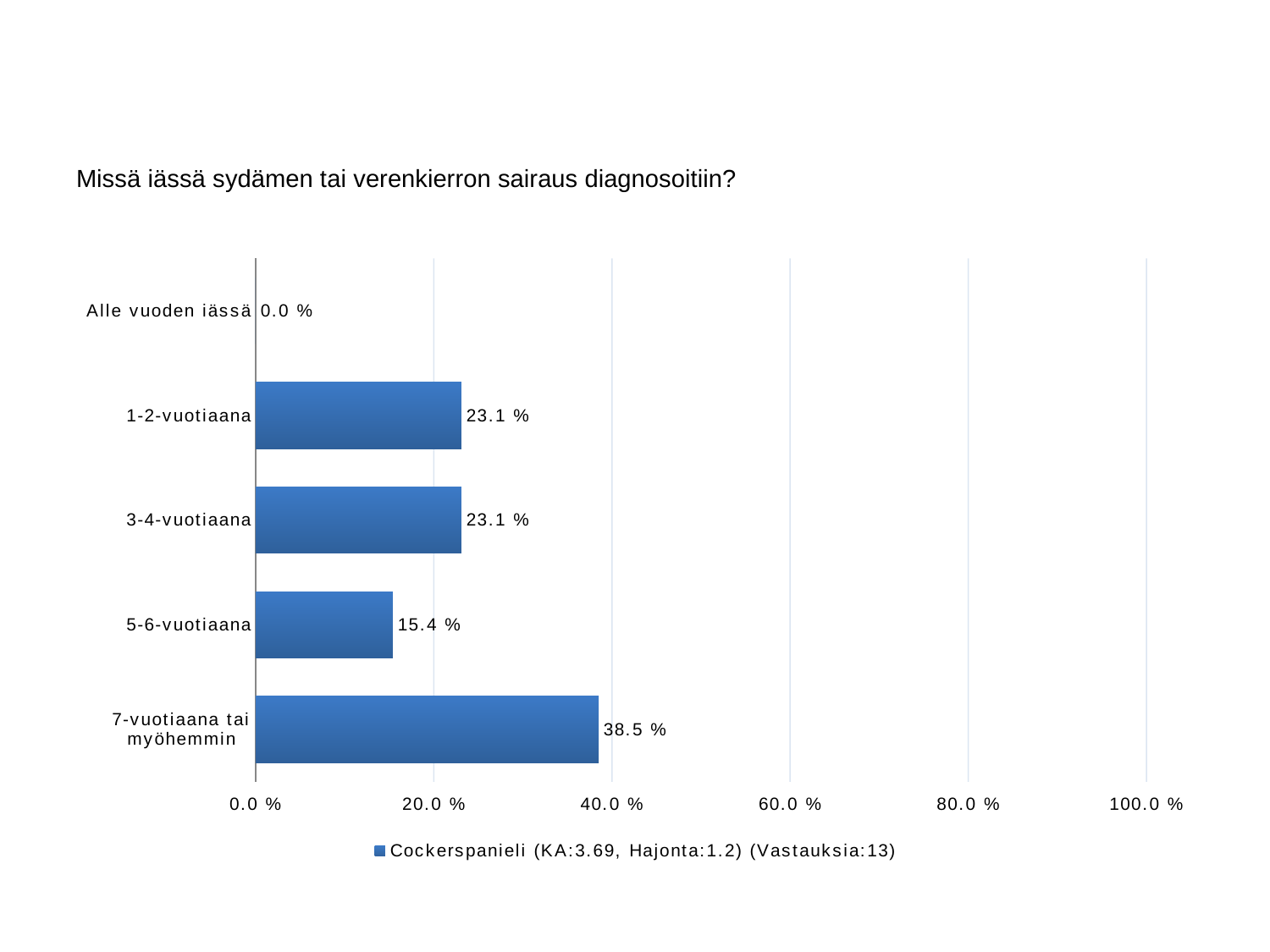
What is the value for 7-vuotiaana tai myöhemmin? 38.5 % Which is larger, the value for 3-4-vuotiaana or the value for 5-6-vuotiaana? 3-4-vuotiaana What is the title of the chart? Missä iässä sydämen tai verenkierron sairaus diagnosoitiin? What kind of chart is shown on the slide? bar chart How many categories are shown on the chart? 5 What is the value for 1-2-vuotiaana? 23.1 % What is the value for Alle vuoden iässä? 0.0 % What is the value for 5-6-vuotiaana? 15.4 % What is the difference between the values for 7-vuotiaana tai myöhemmin and 5-6-vuotiaana? 23.1 % Which category has the highest value? 7-vuotiaana tai myöhemmin Which category has the lowest value? Alle vuoden iässä Is the value for 7-vuotiaana tai myöhemmin greater or less than 40.0 %? less